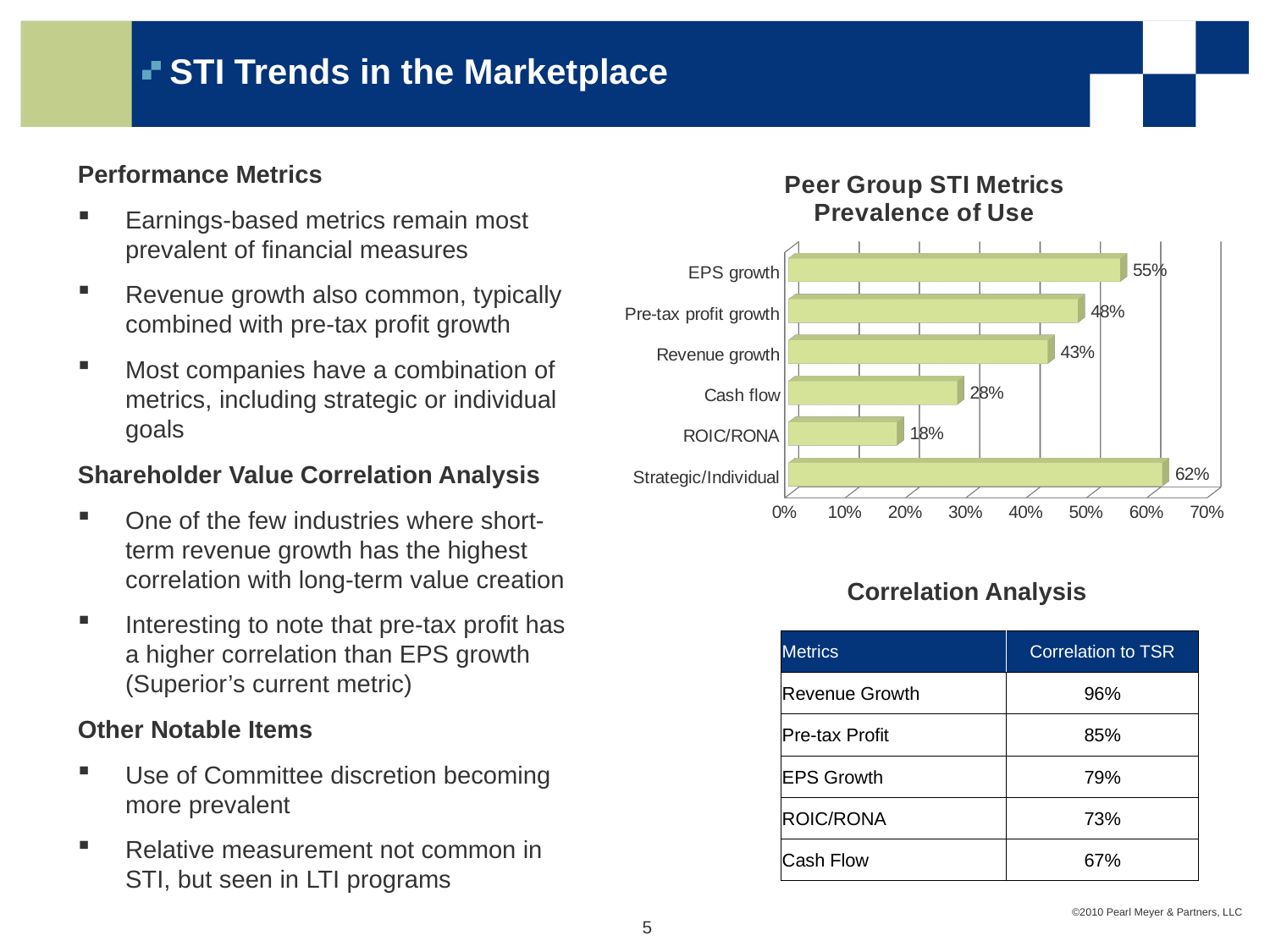
What is the maximum value shown on the horizontal axis of the Peer Group STI Metrics chart? 70% In the Peer Group STI Metrics chart, which has a higher prevalence of use, Revenue growth or Cash flow? Revenue growth Which metric has the highest prevalence of use in the Peer Group STI Metrics chart? Strategic/Individual What is the prevalence of use for ROIC/RONA in the Peer Group STI Metrics chart? 18% What is the difference in prevalence of use between Strategic/Individual and EPS growth in the Peer Group STI Metrics chart? 7% How many metrics are shown in the Peer Group STI Metrics chart? 6 What type of chart is the Peer Group STI Metrics Prevalence of Use chart? Bar chart What is the difference in prevalence of use between Pre-tax profit growth and Revenue growth in the Peer Group STI Metrics chart? 5% In the Peer Group STI Metrics chart, is the value for Pre-tax profit growth greater or less than 40%? greater What is the prevalence of use for EPS growth in the Peer Group STI Metrics chart? 55% Which metric has the lowest prevalence of use in the Peer Group STI Metrics chart? ROIC/RONA What is the prevalence of use for Cash flow in the Peer Group STI Metrics chart? 28%